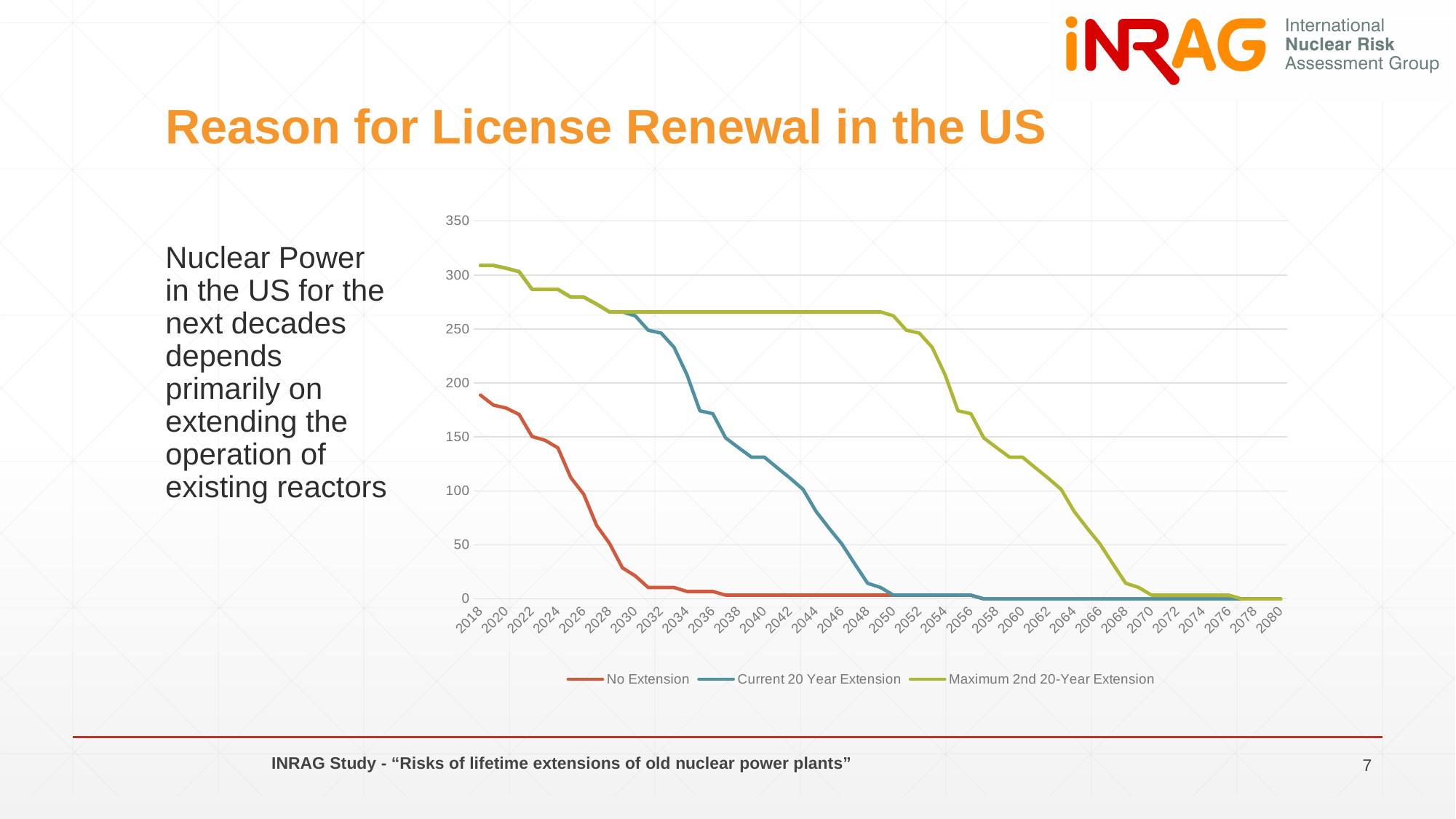
How many series does the legend list? 3 Which series has the highest value in 2018? Current 20 Year Extension and Maximum 2nd 20-Year Extension (tied) What kind of chart is shown on the slide? Line chart What is the first year shown on the x axis? 2018 Is the value for Maximum 2nd 20-Year Extension in 2060 greater or less than 150? less What are the three series named in the legend? No Extension, Current 20 Year Extension, Maximum 2nd 20-Year Extension Is the value for No Extension in 2018 greater or less than 150? greater Do the values for the No Extension series rise or fall along the x axis? Fall Is the value for No Extension in 2030 greater or less than 50? less In 2040, which series has the larger value: No Extension or Current 20 Year Extension? Current 20 Year Extension